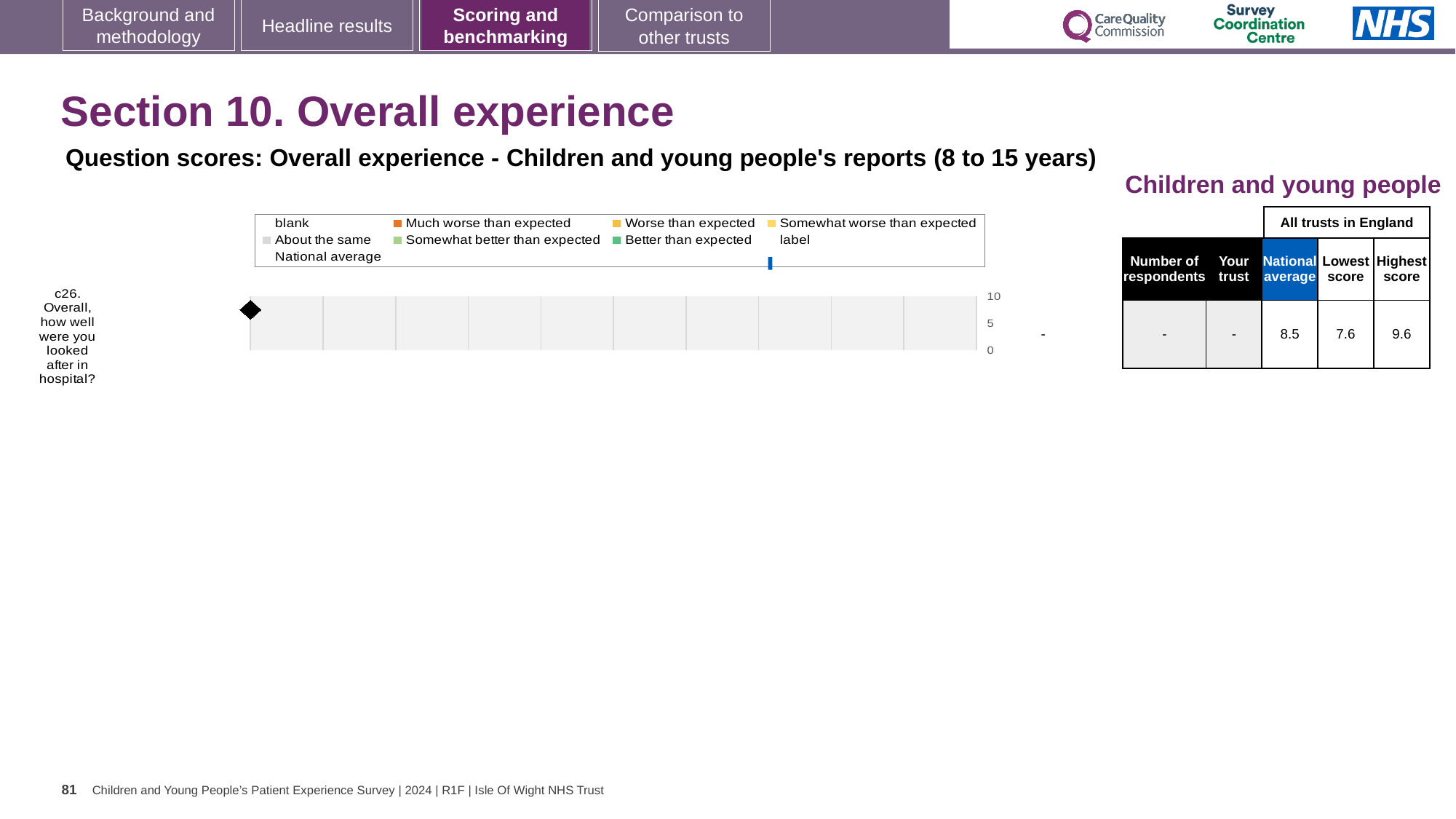
What value is printed for the trust's score for c26 next to the chart? - What is the difference between the highest score and the lowest score shown in the table for c26? 2.0 In the table, what is the national average score for c26? 8.5 How many questions (categories) are plotted in the chart? 1 Which question is plotted in the chart? c26. Overall, how well were you looked after in hospital? In the table, what is the highest score among all trusts in England for c26? 9.6 What kind of chart is used for question c26 on this slide? bar chart Is the national average score for c26 greater or less than 5? greater What is the highest value shown on the chart's vertical axis? 10 In the table, what is the lowest score among all trusts in England for c26? 7.6